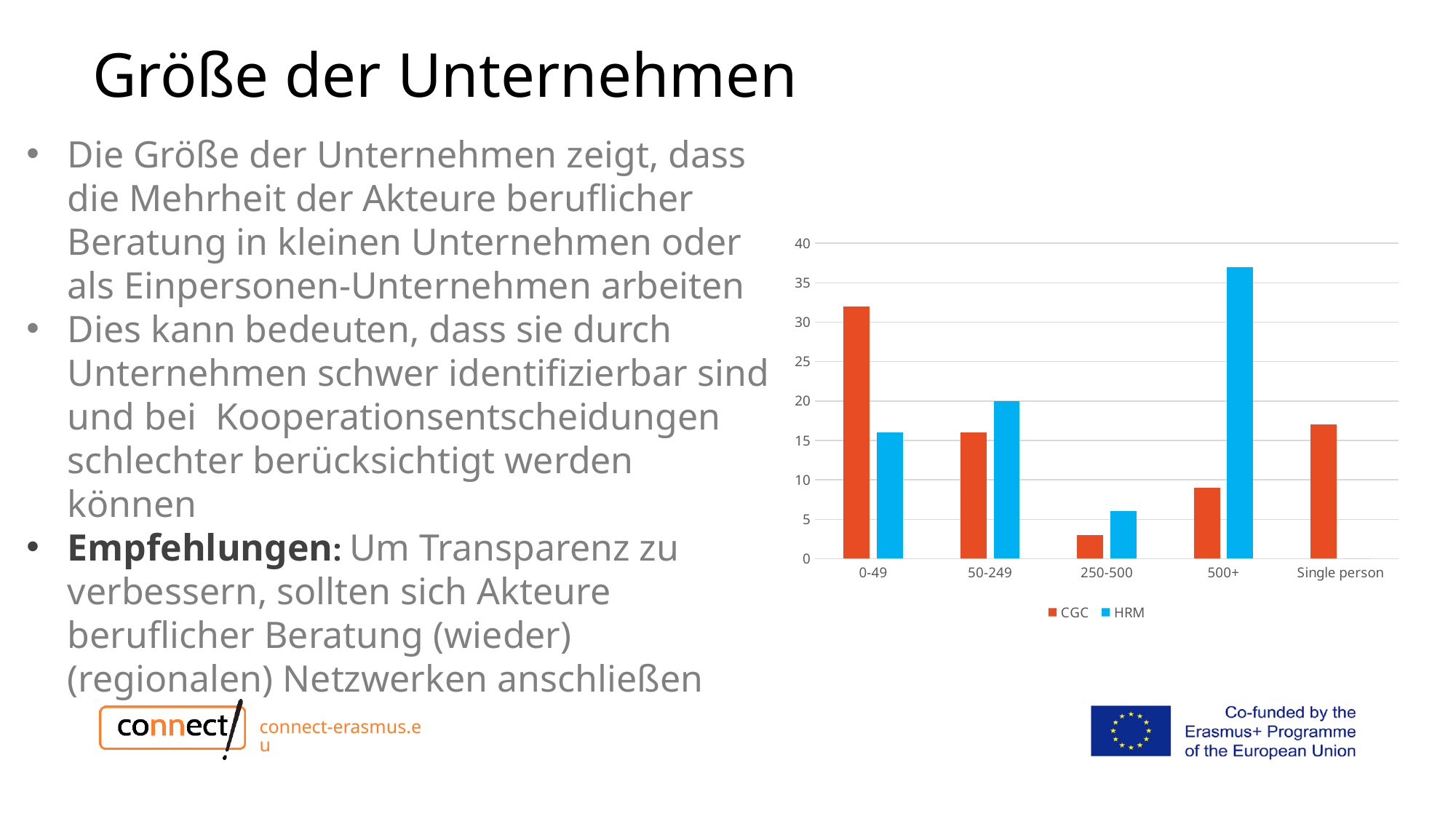
What is the HRM value for the 50-249 category? 20 For the 0-49 category, which series has the larger value, CGC or HRM? CGC Which category has the highest CGC value? 0-49 Which category has the lowest CGC value? 250-500 Which category has the highest HRM value? 500+ What kind of chart is shown on the slide? bar chart Is the CGC value for 500+ greater or less than 10? less How many categories are shown on the x axis of the chart? 5 Is the HRM value for 500+ greater or less than 35? greater Which series is shown in blue in the chart? HRM How many series does the chart legend list? 2 Is the CGC value for 0-49 greater or less than 30? greater